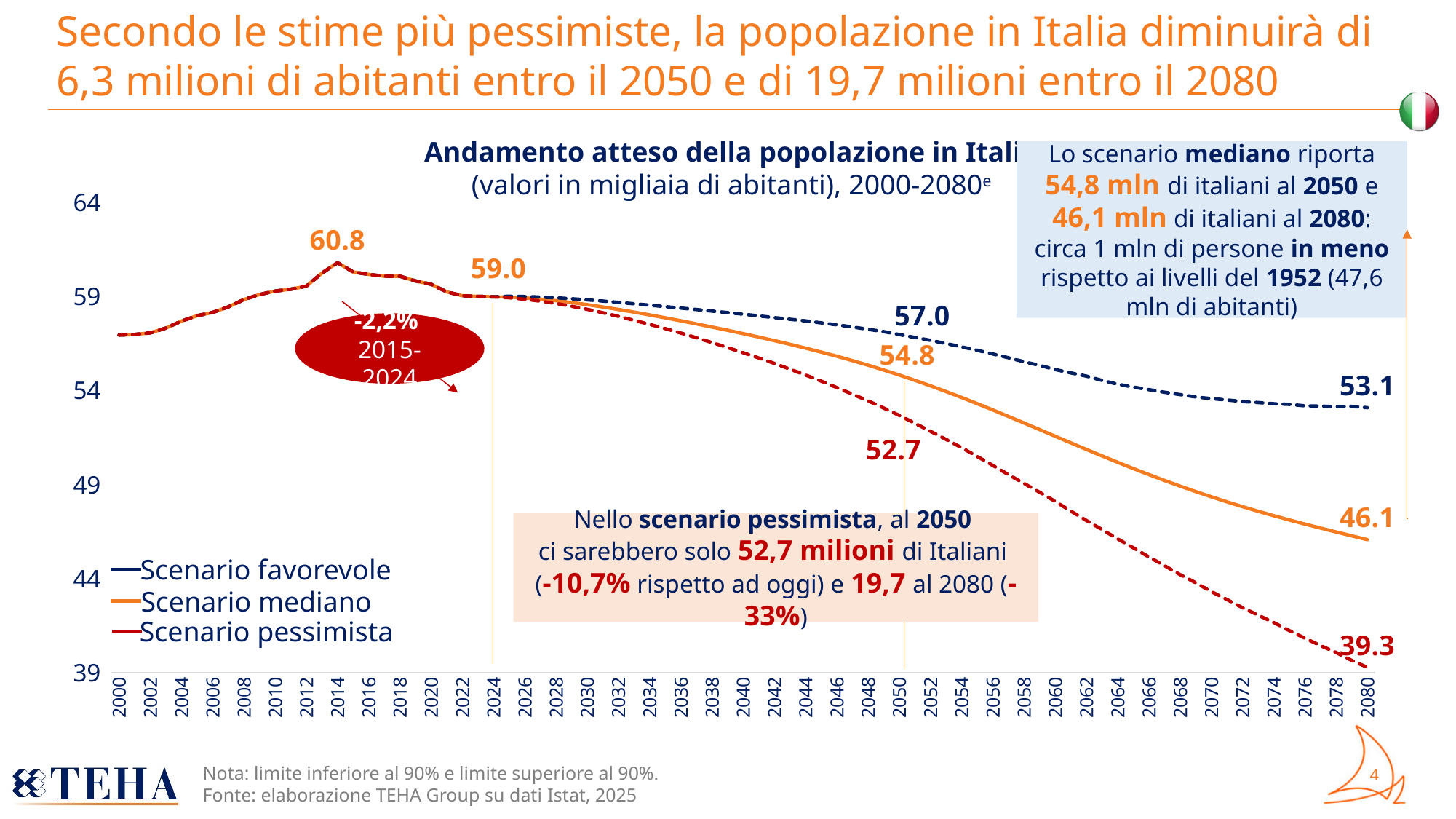
What is the value of the Scenario favorevole in 2080? 53.1 Which colour is used for the Scenario mediano line? orange Which is larger in 2050: the Scenario mediano or the Scenario pessimista? Scenario mediano What type of chart is shown on the slide? line chart How many series does the legend list? 3 What is the peak value labelled on the chart in 2014? 60.8 What is the value of the Scenario mediano in 2050? 54.8 Does the Scenario mediano rise or fall between 2024 and 2080? fall What is the value of the Scenario favorevole in 2050? 57.0 Which scenario has the lowest value in 2080? Scenario pessimista What is the value of the Scenario pessimista in 2080? 39.3 What is the difference between the Scenario favorevole and the Scenario pessimista in 2080? 13.8